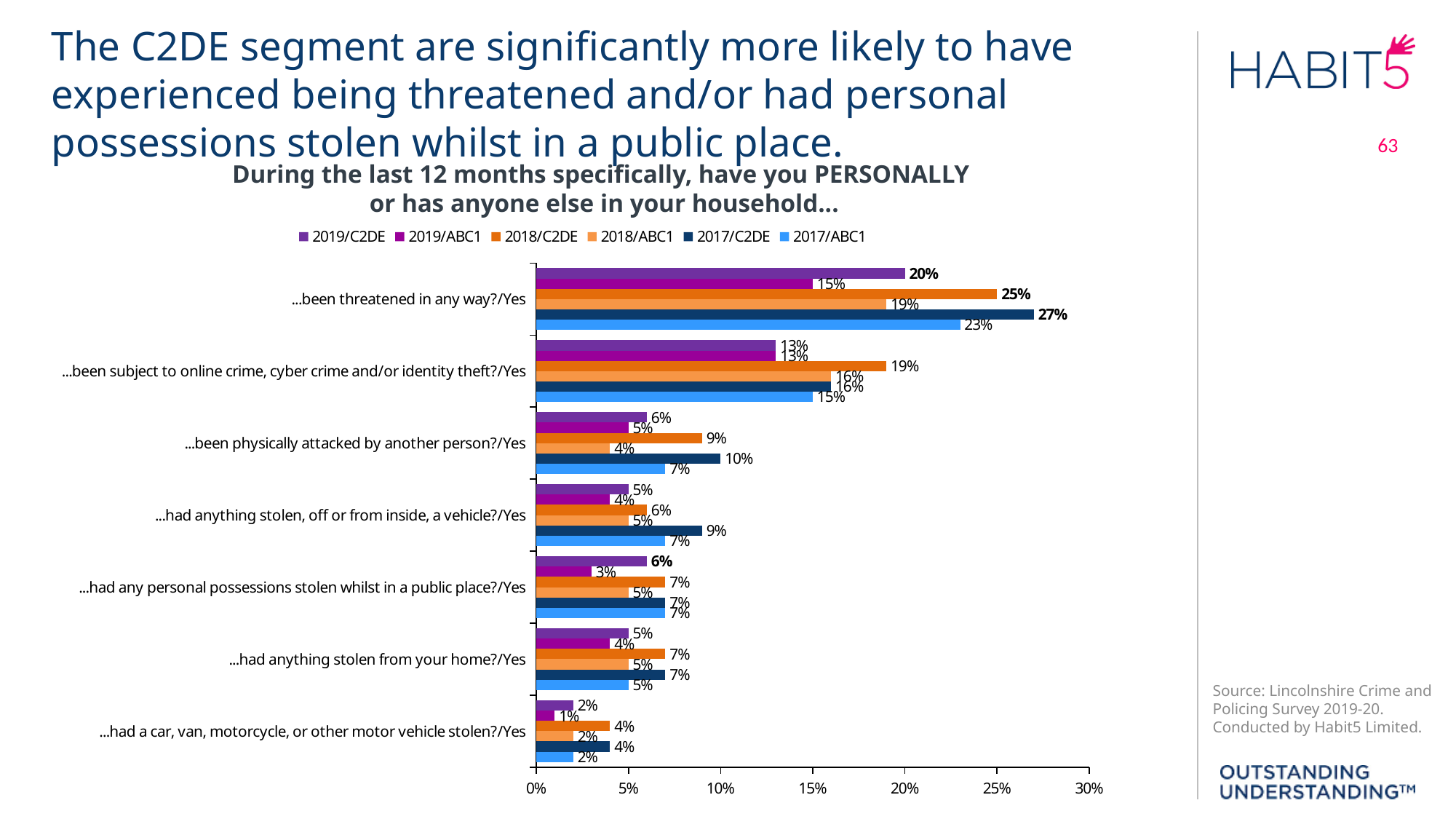
What is the 2019/ABC1 value for "...had any personal possessions stolen whilst in a public place?/Yes"? 3% How many categories are shown on the chart? 7 Which is larger for "...been physically attacked by another person?/Yes": the 2018/C2DE value or the 2018/ABC1 value? 2018/C2DE What is the 2017/C2DE value for "...been threatened in any way?/Yes"? 27% What is the 2018/C2DE value for "...been subject to online crime, cyber crime and/or identity theft?/Yes"? 19% Which category has the lowest 2019/ABC1 value? ...had a car, van, motorcycle, or other motor vehicle stolen?/Yes What is the 2017/ABC1 value for "...had anything stolen from your home?/Yes"? 5% Which category has the highest 2017/C2DE value? ...been threatened in any way?/Yes What kind of chart is shown on the slide? Bar chart How many series does the legend list? 6 What is the 2019/C2DE value for "...been threatened in any way?/Yes"? 20% What is the difference between the 2018/C2DE and 2018/ABC1 values for "...been threatened in any way?/Yes"? 6%